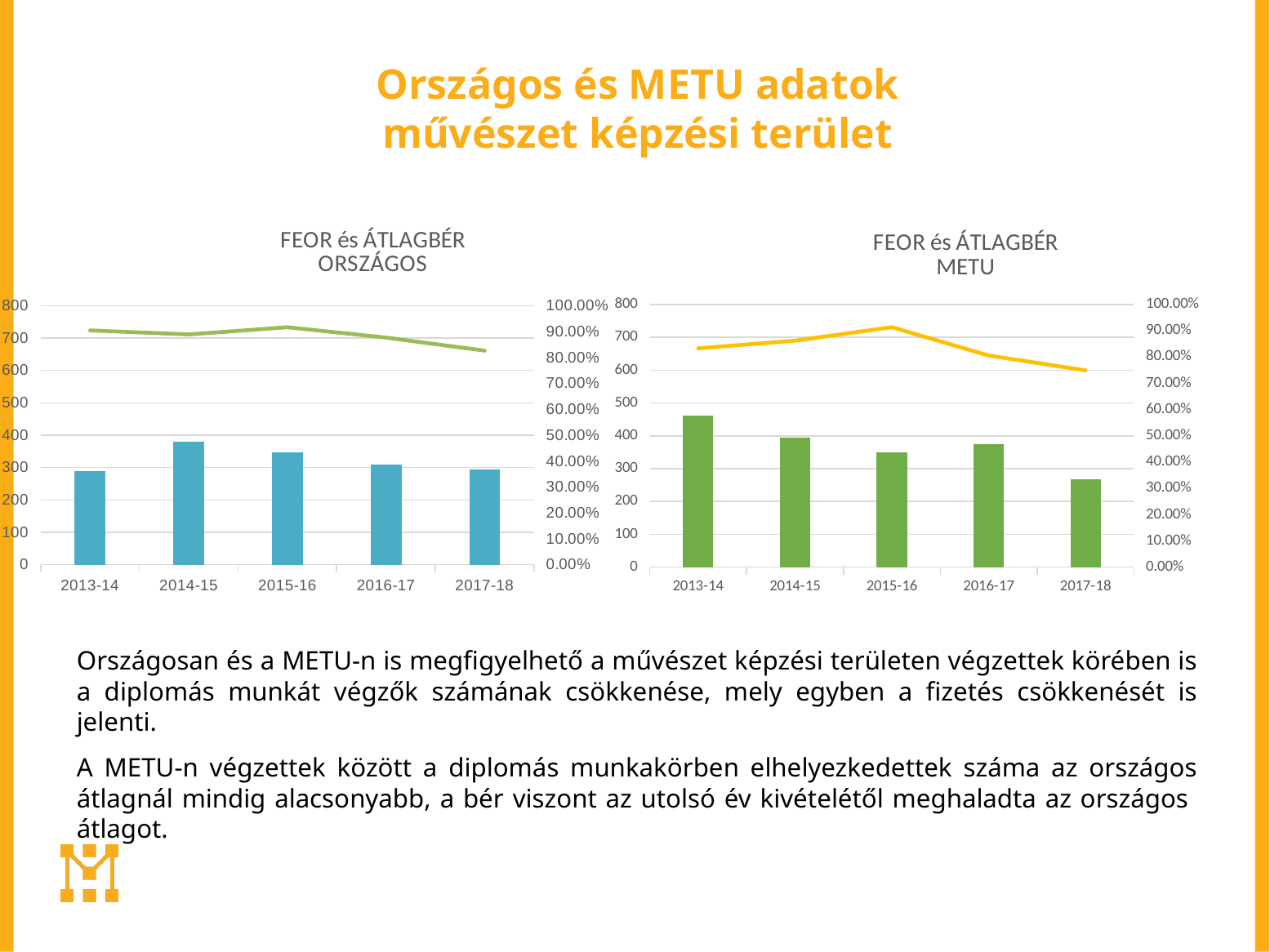
What kind of chart is the left chart titled 'FEOR és ÁTLAGBÉR ORSZÁGOS'? Bar chart with a line In the chart titled 'FEOR és ÁTLAGBÉR ORSZÁGOS', is the bar for 2014-15 greater or less than 300? greater In the chart titled 'FEOR és ÁTLAGBÉR METU', do the bars generally rise or fall from 2013-14 to 2017-18? fall In the chart titled 'FEOR és ÁTLAGBÉR ORSZÁGOS', which bar is taller, 2014-15 or 2017-18? 2014-15 In the chart titled 'FEOR és ÁTLAGBÉR METU', which year has the tallest bar? 2013-14 In the chart titled 'FEOR és ÁTLAGBÉR ORSZÁGOS', which year has the tallest bar? 2014-15 In the chart titled 'FEOR és ÁTLAGBÉR METU', which bar is taller, 2014-15 or 2015-16? 2014-15 In the chart titled 'FEOR és ÁTLAGBÉR METU', is the bar for 2013-14 greater or less than 400? greater In the chart titled 'FEOR és ÁTLAGBÉR METU', is the bar for 2017-18 greater or less than 300? less In the chart titled 'FEOR és ÁTLAGBÉR METU', which year has the shortest bar? 2017-18 How many years are shown on the x axis of the chart titled 'FEOR és ÁTLAGBÉR METU'? 5